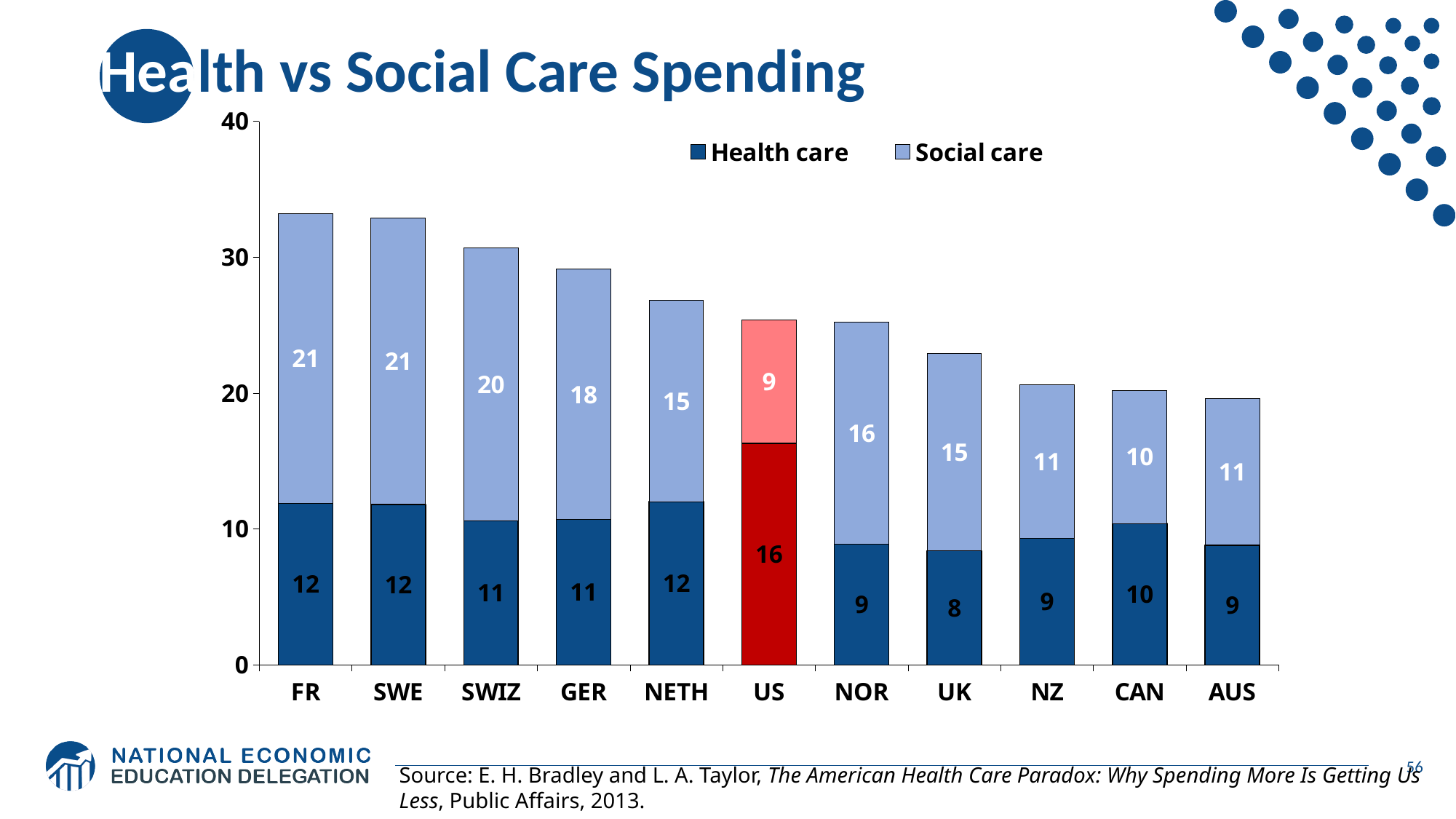
What is the difference between the Social care value for FR and the Social care value for US? 12 How many series does the legend list? 2 What is the Social care value for NOR? 16 What is the Social care value for GER? 18 How many countries are shown on the x axis? 11 What type of chart is shown on the slide? Stacked bar chart Which country has the highest Health care value? US Which is larger for the UK: the Health care value or the Social care value? Social care Which country has the lowest Health care value? UK What is the Health care value for the US? 16 What is the total of the stacked bar for NETH, using the printed labels? 27 Which country has the lowest Social care value? US